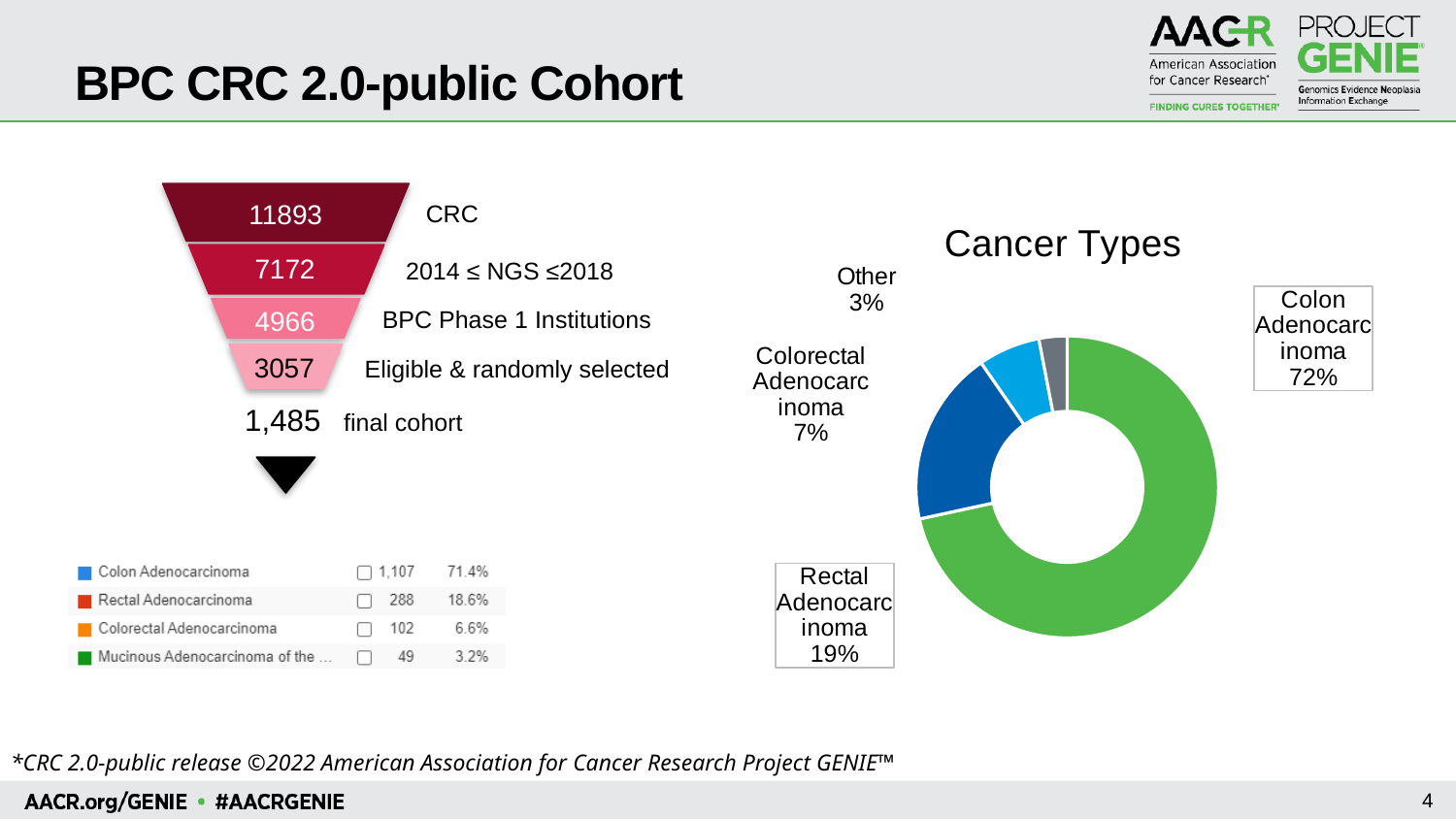
In the Cancer Types chart, which is larger, Rectal Adenocarcinoma or Colorectal Adenocarcinoma? Rectal Adenocarcinoma In the Cancer Types chart, what percentage is labelled Other? 3% What kind of chart is the Cancer Types chart? Donut (pie) chart In the Cancer Types chart, how many percentage points larger is Colon Adenocarcinoma than Rectal Adenocarcinoma? 53 In the Cancer Types chart, which cancer type has the largest share? Colon Adenocarcinoma How many categories are shown in the Cancer Types chart? 4 In the Cancer Types chart, which category has the smallest share? Other In the Cancer Types chart, what percentage is shown for Colorectal Adenocarcinoma? 7% In the Cancer Types chart, what share of the cohort is Colon Adenocarcinoma? 72% In the funnel chart on the left, what is the value for the final cohort? 1,485 In the funnel chart on the left, what is the value for the CRC stage at the top? 11893 In the Cancer Types chart, what percentage is labelled for Rectal Adenocarcinoma? 19%